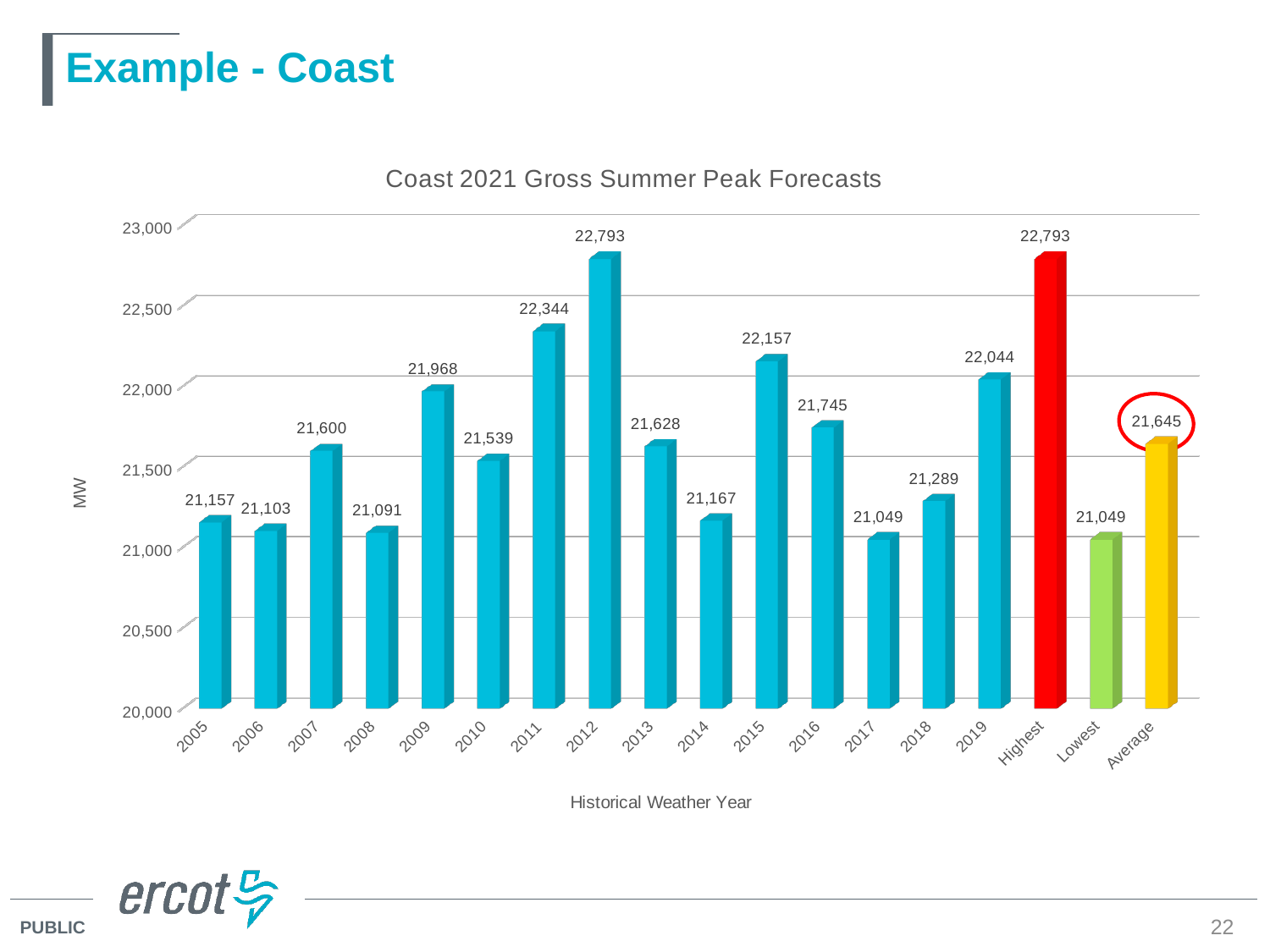
Which historical weather year has the highest forecast value? 2012 Is the value for 2009 greater or less than 22,000? less Which is larger, the value for 2015 or the value for 2019? 2015 What is the difference between the values for 2011 and 2010? 805 What is the difference between the Highest and Lowest bars? 1,744 Which historical weather year has the lowest forecast value? 2017 What is the value of the Average bar? 21,645 What kind of chart is shown on the slide? bar chart How many historical weather years (2005 through 2019) are plotted in the chart? 15 What is the label of the y axis? MW What is the value for 2017 in the chart? 21,049 What is the value for 2012 in the Coast 2021 Gross Summer Peak Forecasts chart? 22,793